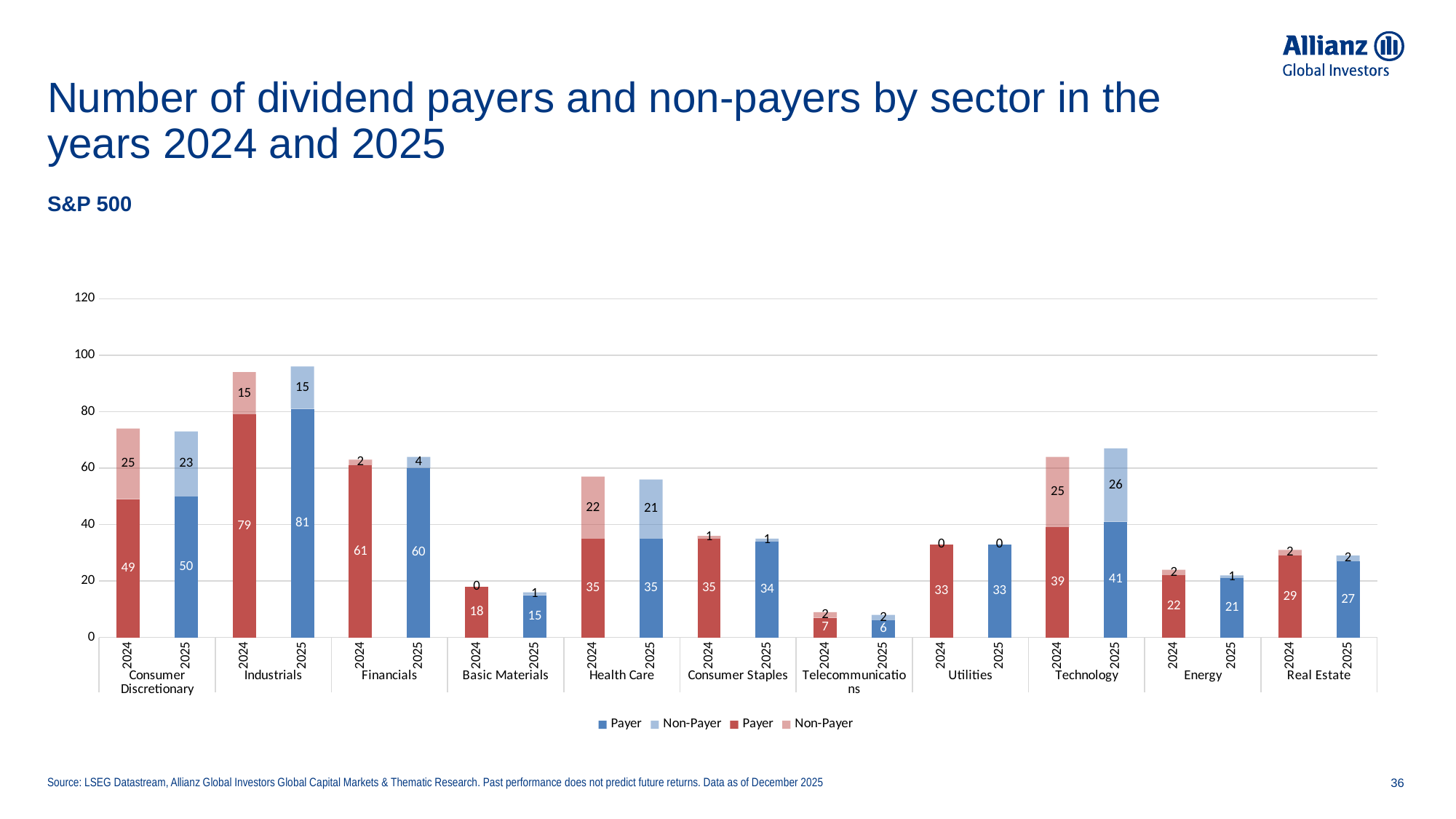
Which sector had the lowest number of dividend payers in 2025? Telecommunications What is the total number of companies (payers plus non-payers) in the Industrials sector in 2025? 96 Which sector had the highest number of dividend payers in 2024? Industrials How many dividend payers did the Industrials sector have in 2025? 81 How many sectors are shown on the x axis of the chart? 11 Which index does the chart cover, according to the subtitle? S&P 500 What type of chart is used on this slide? Stacked bar chart Which had more non-payers in 2024: Health Care or Technology? Technology Is the total height of the Industrials 2024 bar greater or less than 80? greater By how much did the number of non-payers in Consumer Discretionary change from 2024 (25) to 2025 (23)? 2 How many non-payers did the Technology sector have in 2025? 26 How many entries does the chart legend list? 4